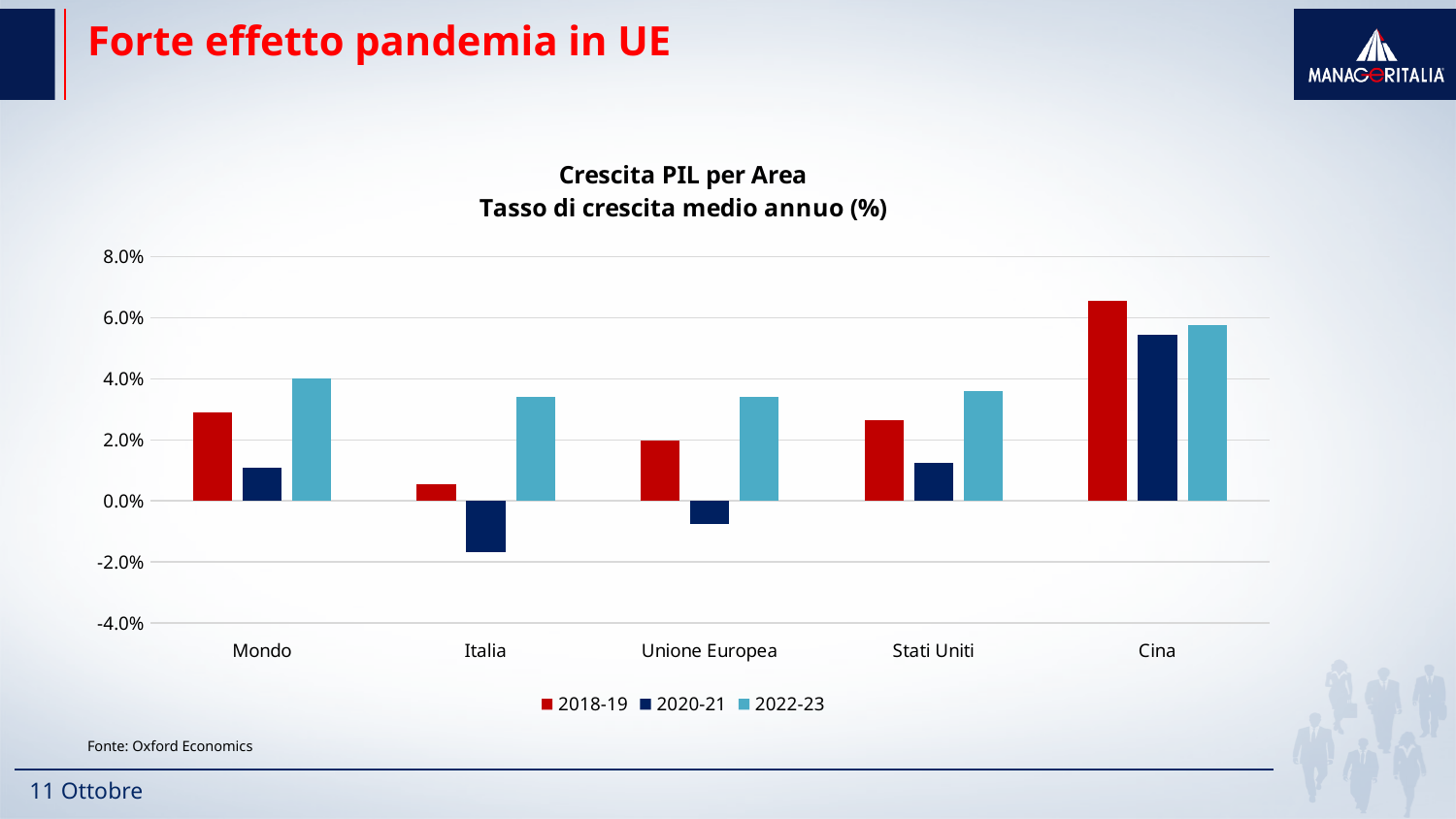
Which area has the lowest value for the 2020-21 series? Italia For Mondo, which series has the larger value: 2018-19 or 2022-23? 2022-23 What kind of chart is shown on the slide? Bar chart How many series does the legend list? 3 What is the source cited below the chart? Oxford Economics Is the 2018-19 value for Cina greater or less than 6.0%? greater How many areas (categories) are shown on the x axis of the chart? 5 Is the 2020-21 value for Italia greater or less than 0.0%? less What is the title of the chart? Crescita PIL per Area - Tasso di crescita medio annuo (%) Which area has the highest value for the 2018-19 series? Cina Is the 2022-23 value for Stati Uniti greater or less than 4.0%? less For the 2020-21 series, which is larger: Stati Uniti or Unione Europea? Stati Uniti